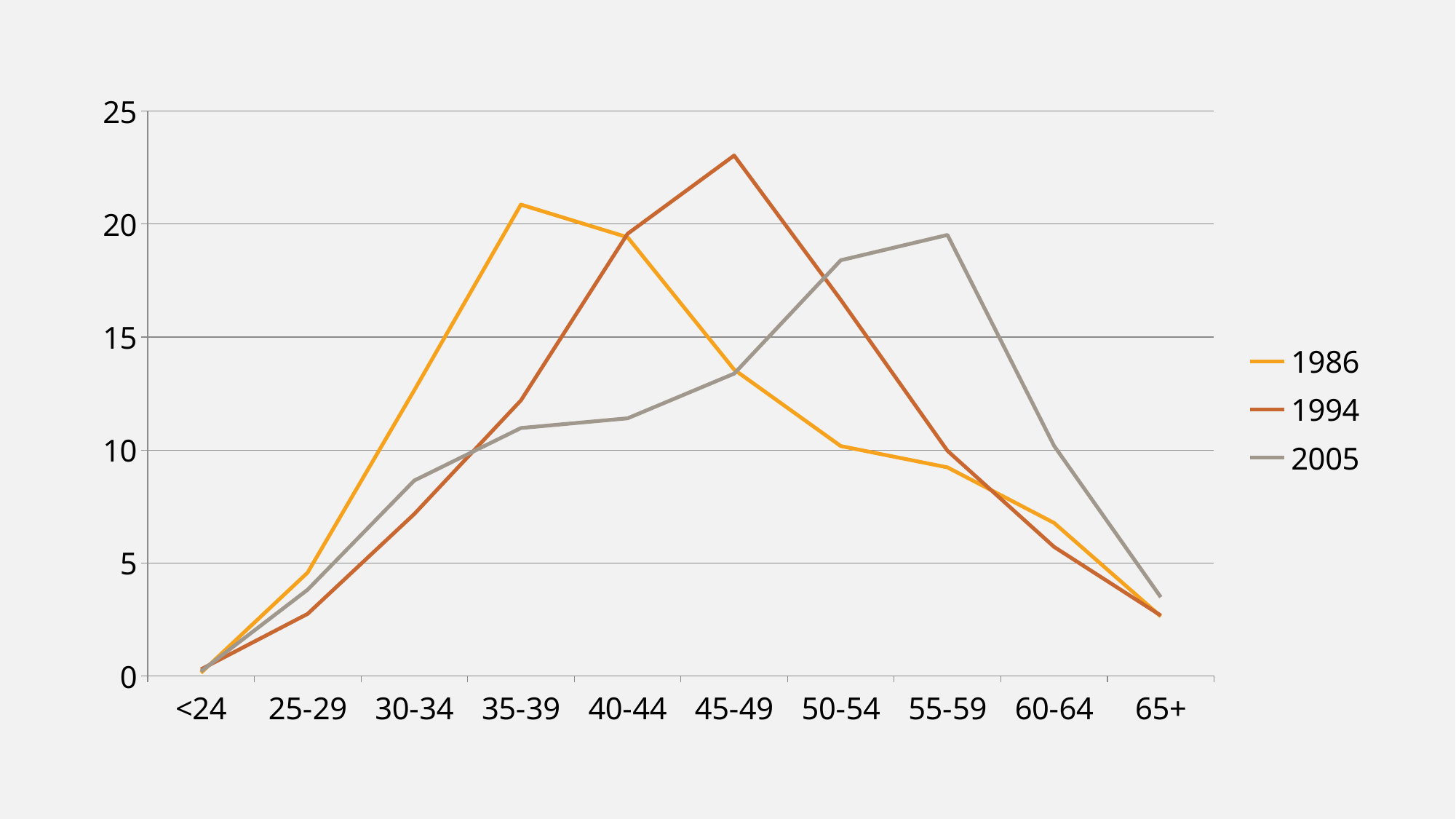
Is the value for 1994 at 25-29 greater or less than 5? less How many series does the legend list? 3 Is the value for 1994 at 45-49 greater or less than 20? greater Which age group has the highest value for the 1994 series? 45-49 At 35-39, which series has the larger value, 1986 or 1994? 1986 Is the value for 2005 at 45-49 greater or less than 15? less Which age group has the lowest value for the 1994 series? <24 How many age-group categories are shown on the x axis? 10 Does the 1986 series rise or fall from 35-39 to 65+? fall What kind of chart is shown on the slide? line chart Which age group has the highest value for the 1986 series? 35-39 Which age group has the highest value for the 2005 series? 55-59